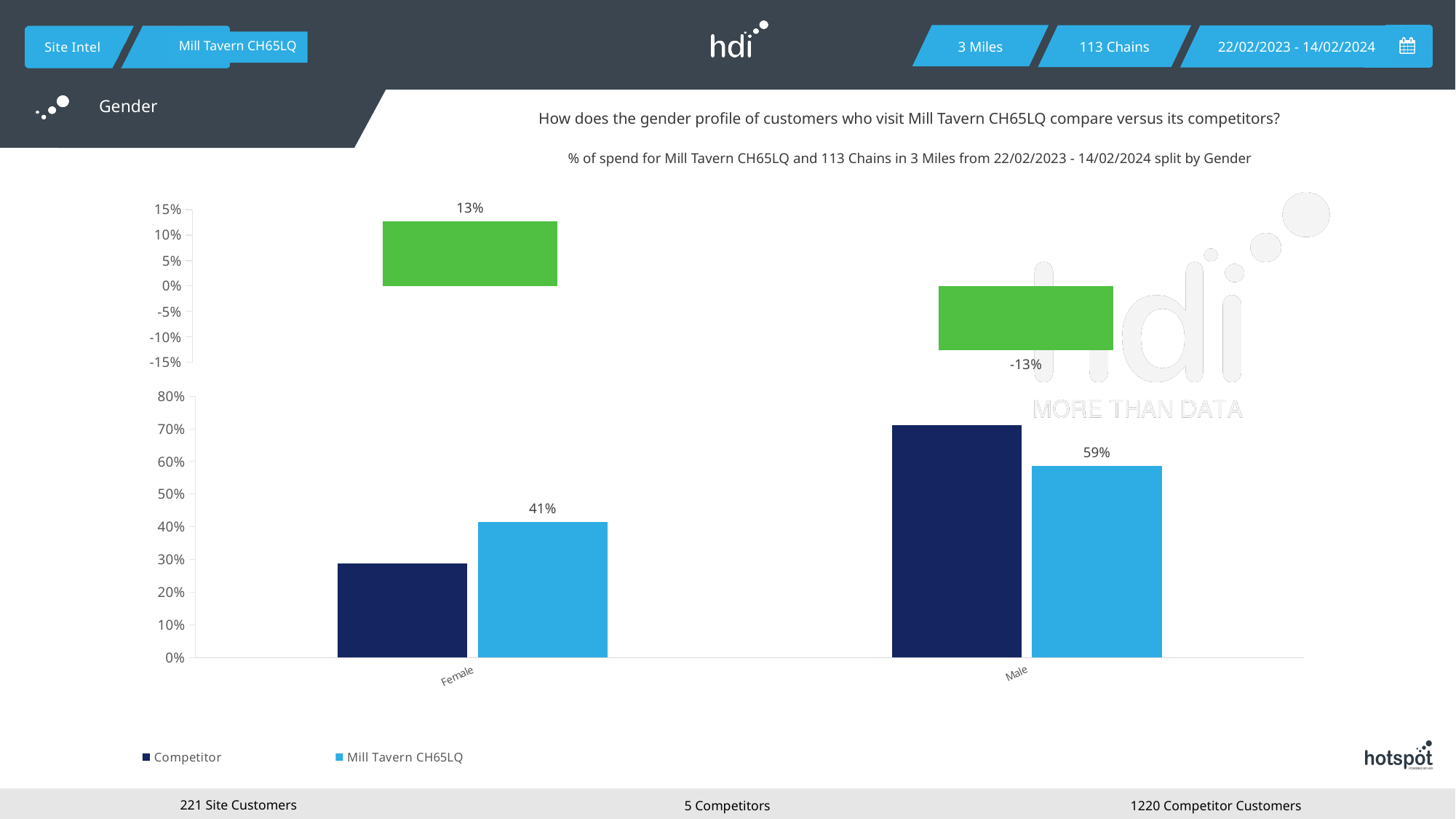
In the top chart, what is the value shown for Male? -13% In the bottom bar chart, what is the value for Mill Tavern CH65LQ for Male? 59% In the bottom bar chart, what is the difference between the Mill Tavern CH65LQ values for Male and Female? 18% In the top chart, what is the value shown for Female? 13% How many categories are shown on the x axis of the bottom bar chart? 2 What kind of chart is the bottom chart? bar chart In the bottom bar chart, what is the value for Mill Tavern CH65LQ for Female? 41% In the bottom bar chart, for Female, which series has the larger value, Competitor or Mill Tavern CH65LQ? Mill Tavern CH65LQ How many series does the legend of the bottom bar chart list? 2 In the bottom bar chart, which category has the higher value for Mill Tavern CH65LQ, Female or Male? Male